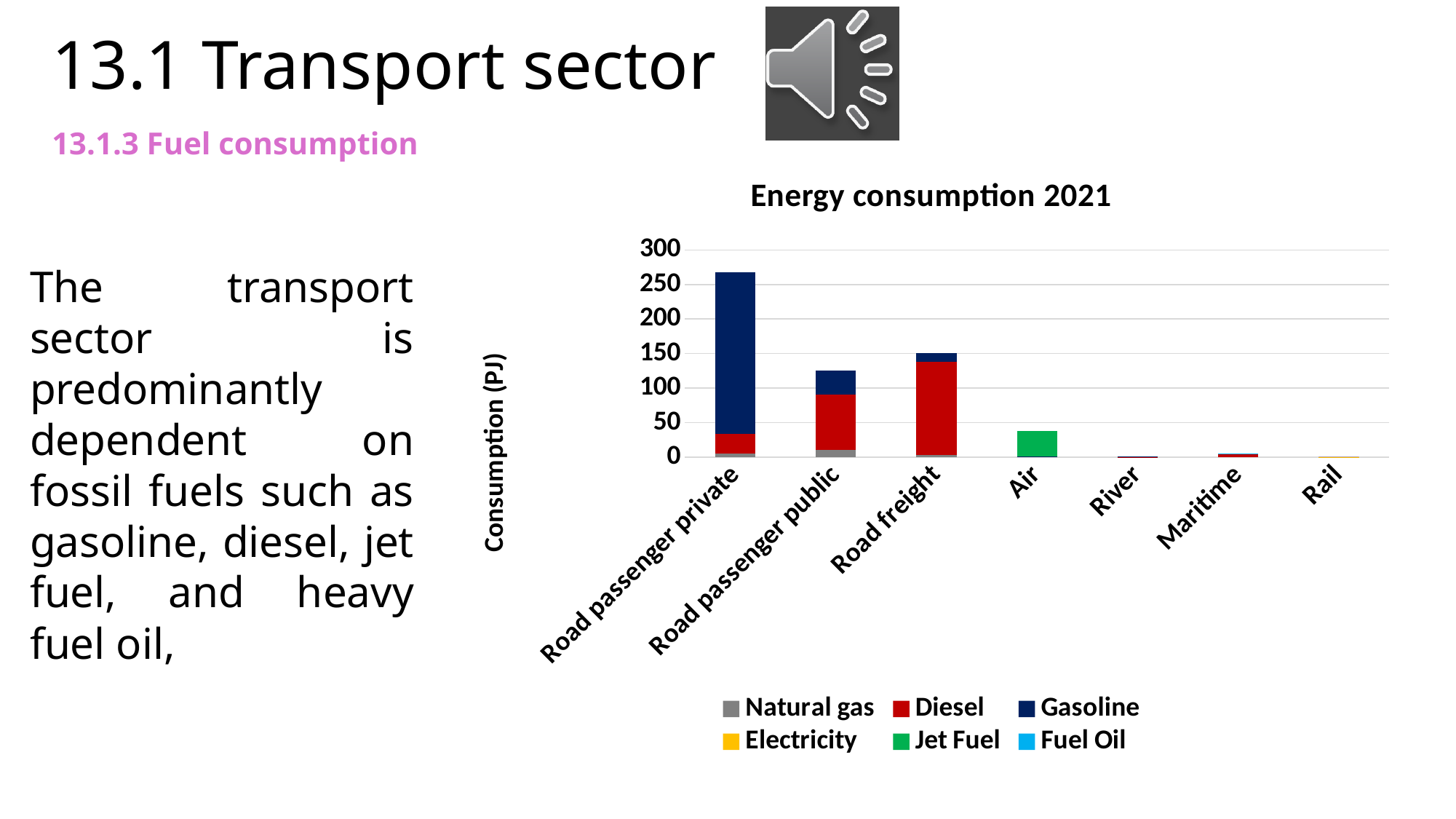
How many transport categories are shown on the x axis of the chart? 7 Which has a larger total energy consumption, Air or Road freight? Road freight What is the label of the y axis of the chart? Consumption (PJ) Is the total value for Road freight greater or less than 100? greater What is the title of the chart? Energy consumption 2021 Which transport category has the highest total energy consumption in the chart? Road passenger private Is the value for Air greater or less than 50? less Is the total value for Road passenger private greater or less than 250? greater How many series does the chart legend list? 6 Which has a larger total energy consumption, Road freight or Road passenger public? Road freight What type of chart is shown on the slide? Stacked bar chart